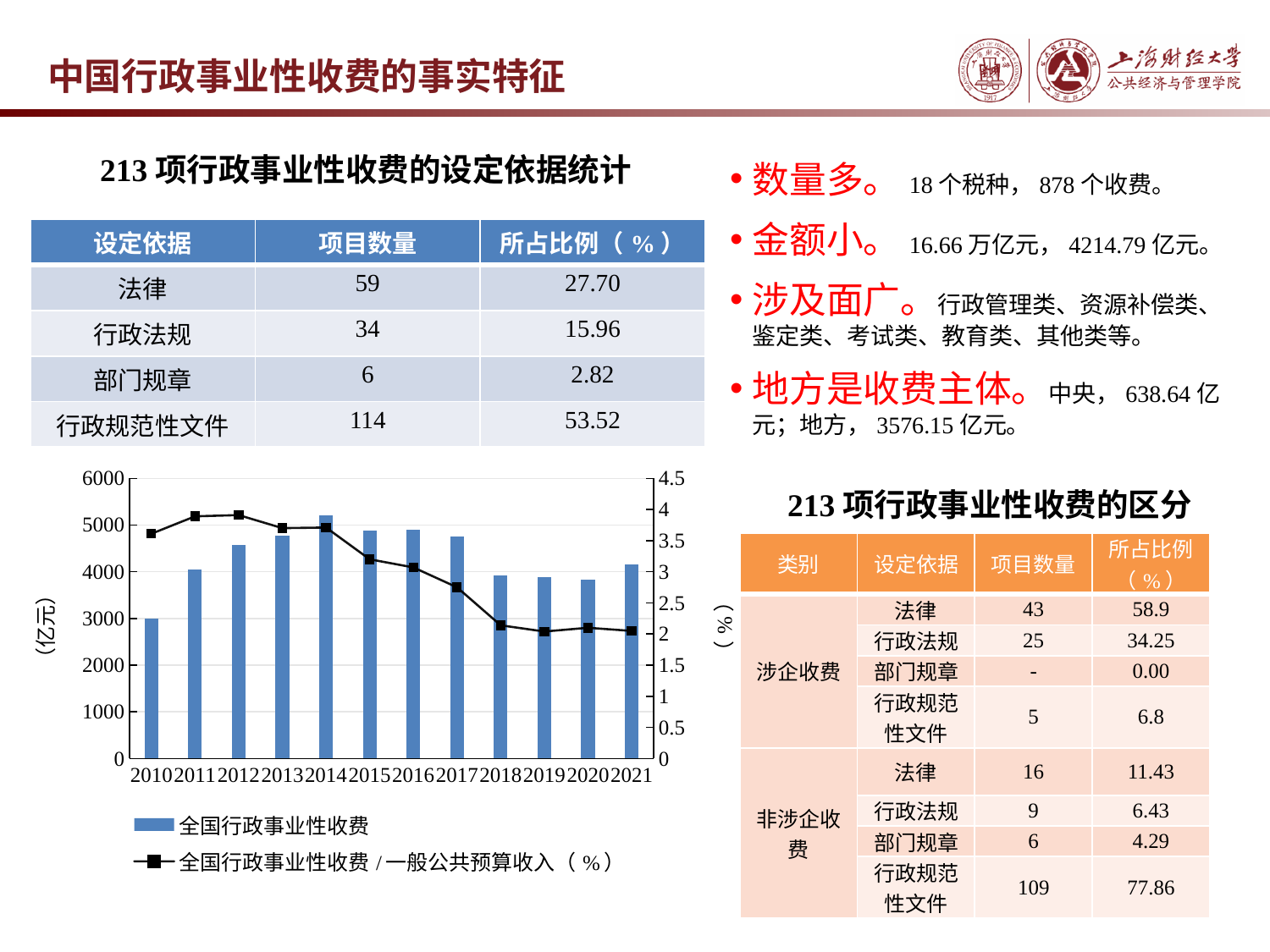
How many series does the chart legend list? 2 In which year is the bar for 全国行政事业性收费 the lowest? 2010 What kind of chart is shown on the slide? A combined bar and line chart How many years are plotted along the x axis of the chart? 12 What unit is shown on the left vertical axis of the chart? 亿元 Is the value of 全国行政事业性收费 / 一般公共预算收入 (%) for 2010 greater or less than 3? greater Is the value of 全国行政事业性收费 for 2014 greater or less than 5000? greater Is the value of 全国行政事业性收费 for 2010 greater or less than 4000? less In which year is the bar for 全国行政事业性收费 the highest? 2014 Which year has the larger bar for 全国行政事业性收费, 2011 or 2012? 2012 Does the line for 全国行政事业性收费 / 一般公共预算收入 (%) generally rise or fall from 2010 to 2021? fall